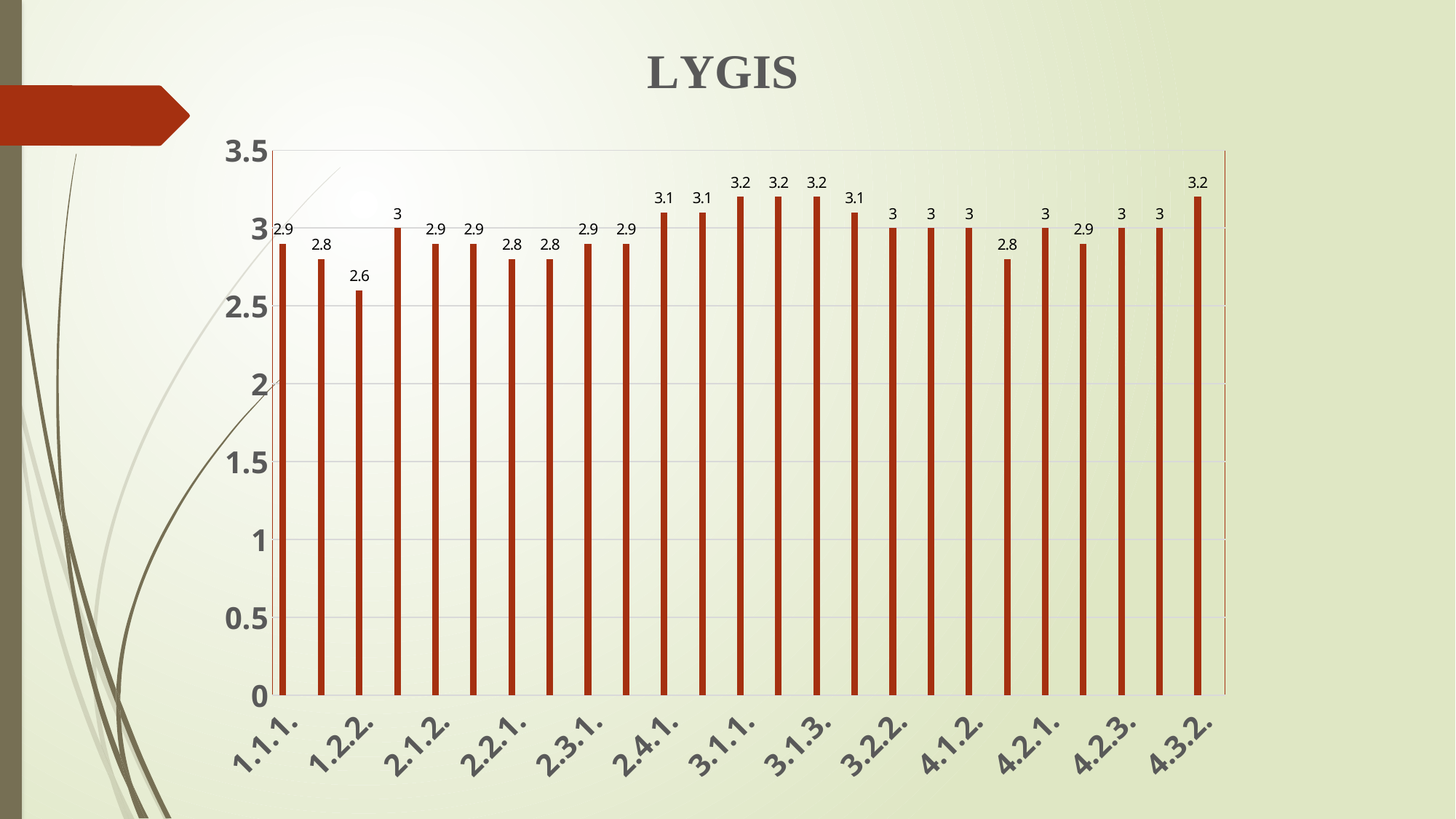
What is the value for category 2.4.1.? 3.1 What kind of chart is shown on the slide? bar chart How many bars are plotted in the chart? 25 What is the difference between the values for 3.1.1. and 2.2.1.? 0.4 What is the difference between the values for 4.3.2. and 1.2.2.? 0.6 What is the value for category 1.2.2.? 2.6 What is the value for category 1.1.1.? 2.9 Which labelled category has the lowest value? 1.2.2. What is the title of the chart? LYGIS What is the value for category 4.3.2.? 3.2 Which is larger, the value for 2.2.1. or the value for 3.1.1.? 3.1.1. Is the value for 1.2.2. greater or less than 3? less